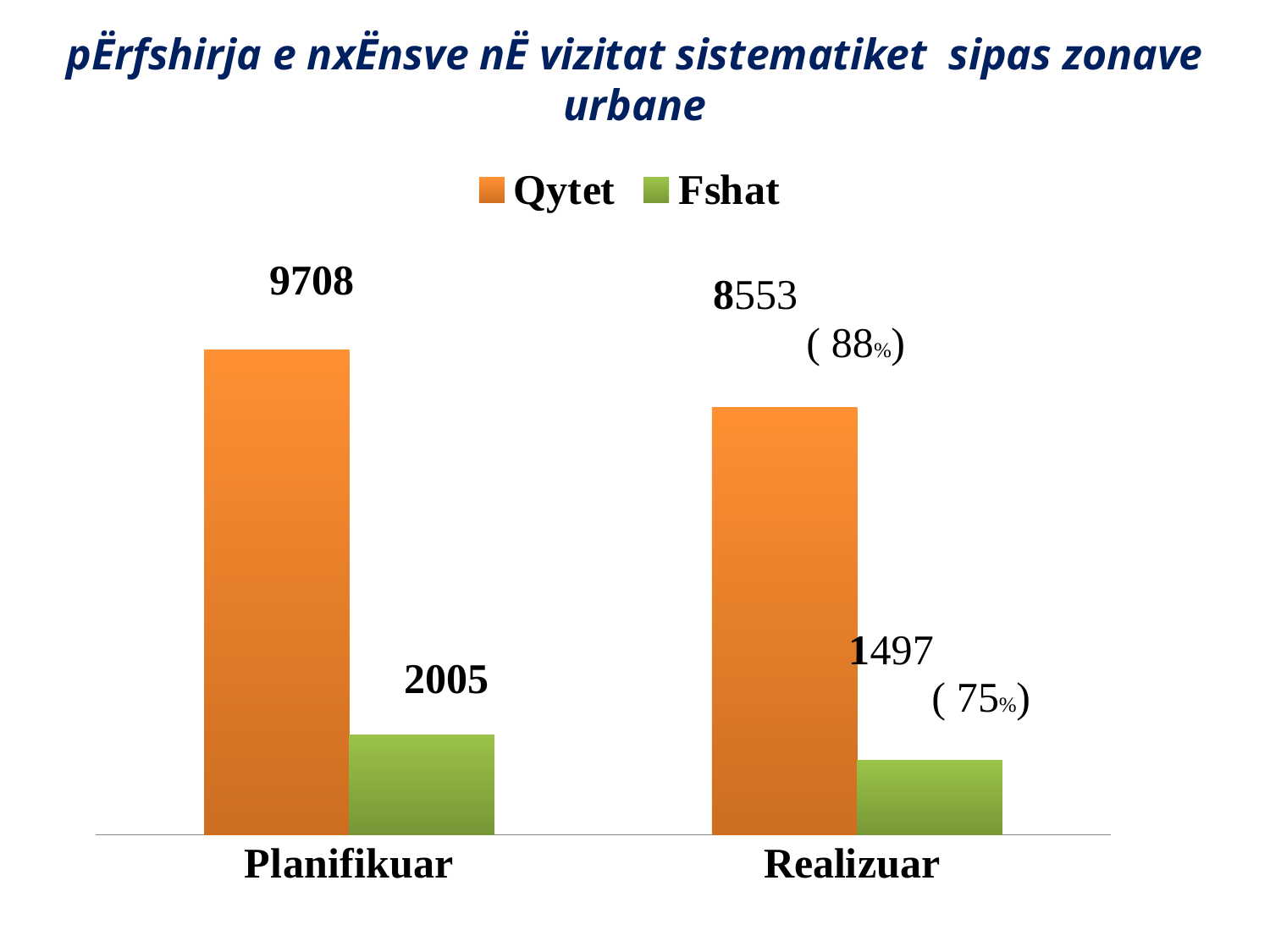
Which bar has the lowest value on the chart? Fshat, Realizuar How many series does the legend list? 2 What is the value for Fshat in the Realizuar category? 1497 What is the value for Fshat in the Planifikuar category? 2005 Which is larger: the Fshat value for Planifikuar or for Realizuar? Planifikuar What is the value for Qytet in the Planifikuar category? 9708 What is the value for Qytet in the Realizuar category? 8553 What is the difference between the Qytet values for Planifikuar and Realizuar? 1155 What percentage is shown next to the Fshat bar in the Realizuar category? 75% What kind of chart is shown on the slide? Bar chart What percentage is shown next to the Qytet bar in the Realizuar category? 88% Which bar has the highest value on the chart? Qytet, Planifikuar